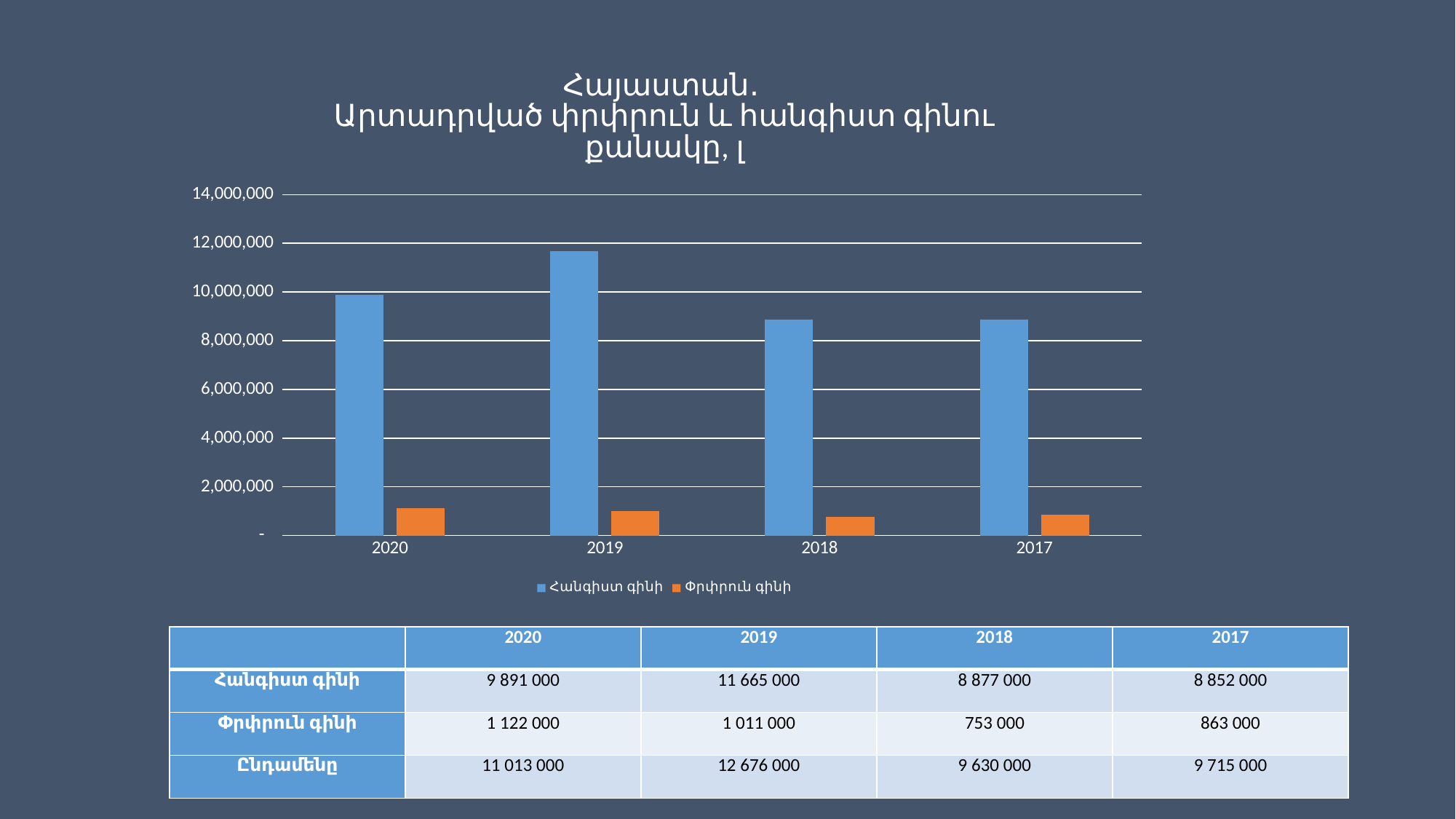
How many series does the chart legend list? 2 In which year is Փրփրուն գինի lowest? 2018 How many years are shown on the x axis of the chart? 4 What is the value of Փրփրուն գինի for 2018? 753 000 What kind of chart is shown on the slide? Bar chart What is the value of Հանգիստ գինի for 2019? 11 665 000 What is the difference between Հանգիստ գինի in 2019 and in 2020? 1 774 000 Which is larger: Փրփրուն գինի in 2020 or in 2019? 2020 Is the value of Հանգիստ գինի for 2018 greater or less than 10,000,000? less In which year is Հանգիստ գինի highest? 2019 What is the value of Հանգիստ գինի for 2020? 9 891 000 Which colour represents Փրփրուն գինի in the chart? Orange